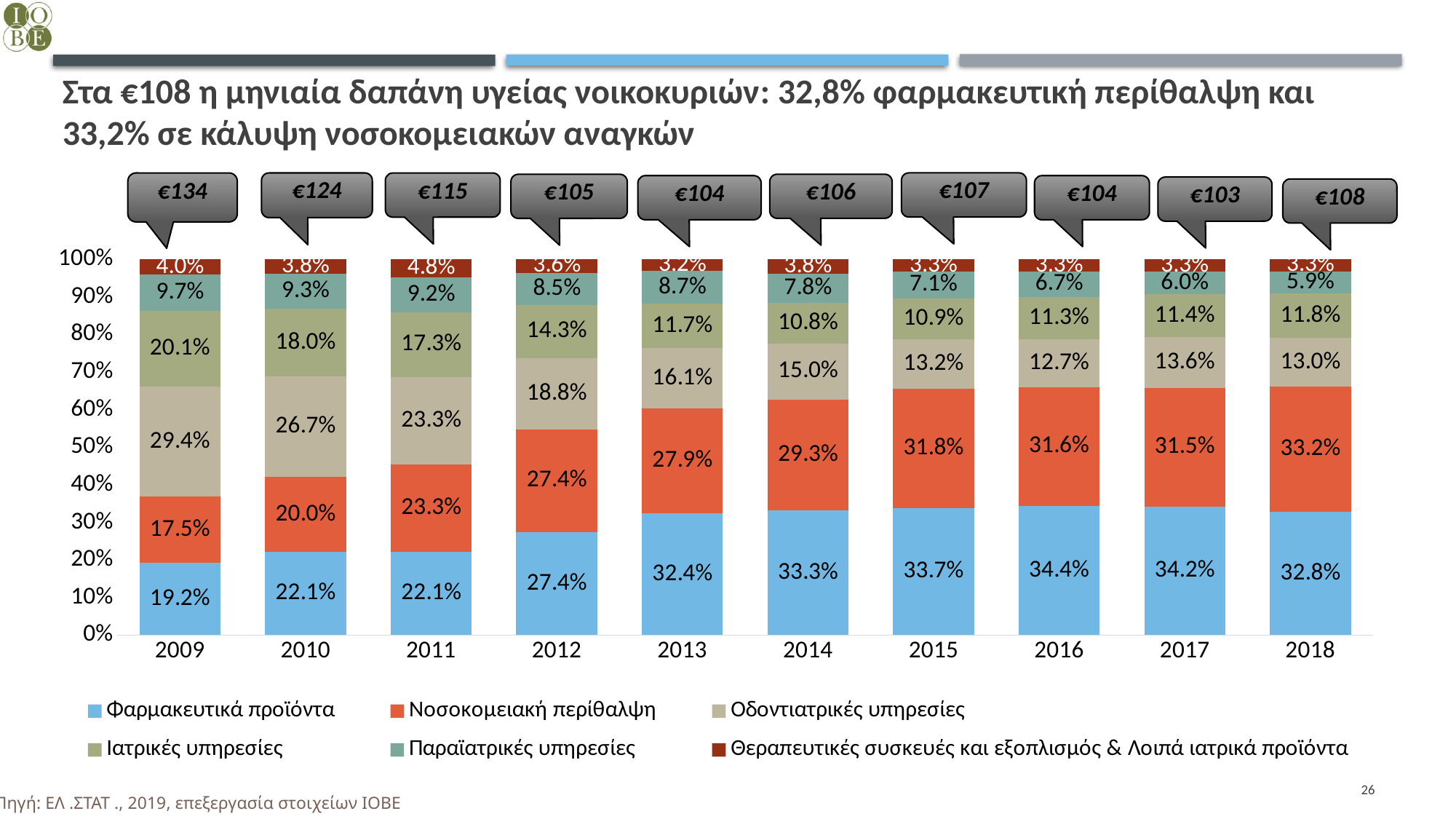
How many series does the legend list? 6 What monthly amount is shown in the callout above the 2012 bar? €105 What type of chart is shown on the slide? Stacked bar chart In 2018, which is larger: the share of Φαρμακευτικά προϊόντα or the share of Νοσοκομειακή περίθαλψη? Νοσοκομειακή περίθαλψη What share did Οδοντιατρικές υπηρεσίες account for in 2009? 29.4% Which year has the highest monthly health expenditure shown in the callouts? 2009 What share of household health spending went to Φαρμακευτικά προϊόντα in 2018? 32.8% How many years are shown on the x axis of the chart? 10 Which series is shown in blue at the bottom of each bar? Φαρμακευτικά προϊόντα By how many percentage points did the share of Νοσοκομειακή περίθαλψη change from 2009 to 2018? 15.7 percentage points Which year has the lowest monthly health expenditure shown in the callouts? 2017 Does the share of Οδοντιατρικές υπηρεσίες rise or fall from 2009 to 2018? Fall